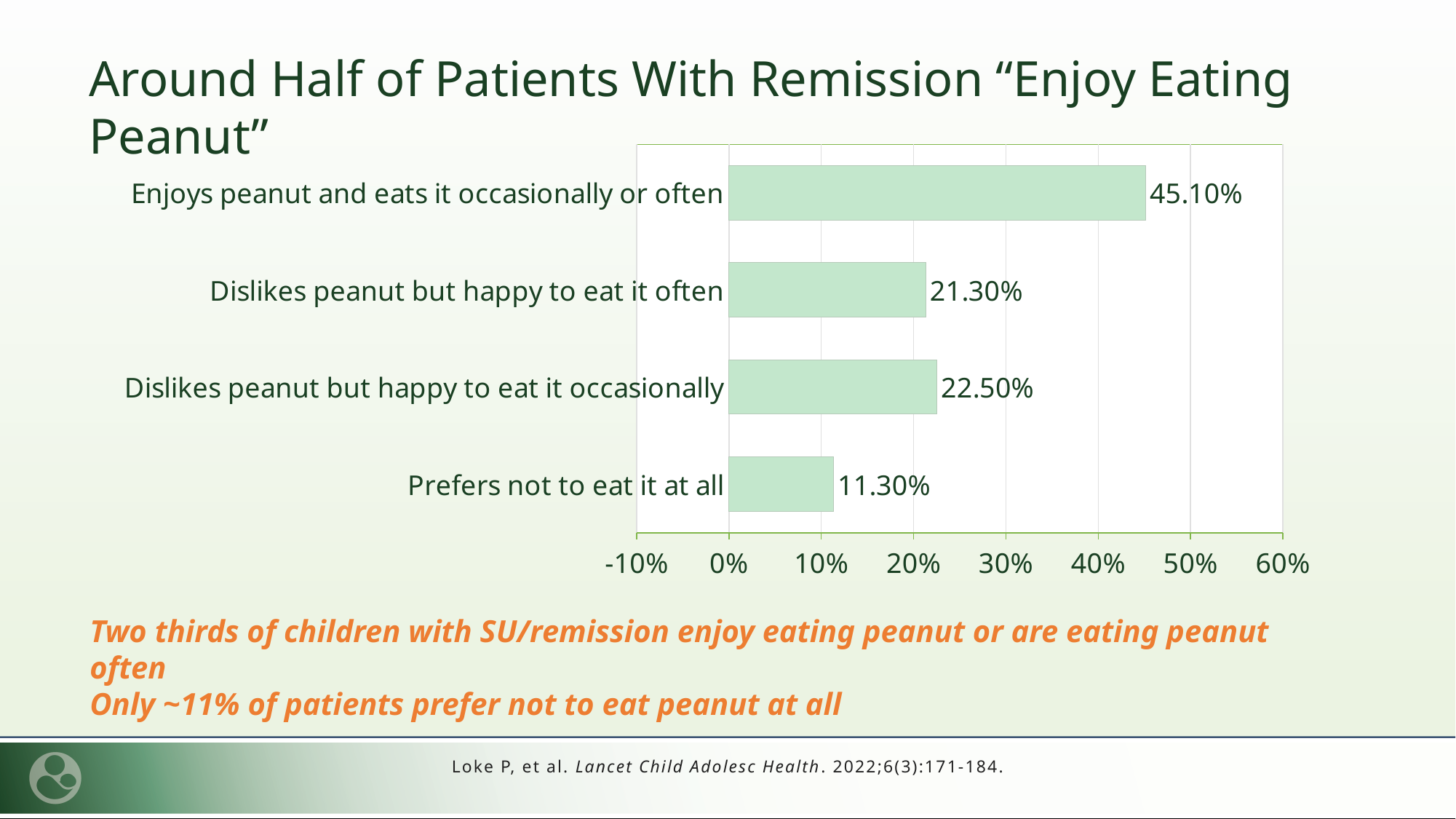
What is the difference between the values for "Dislikes peanut but happy to eat it occasionally" and "Dislikes peanut but happy to eat it often"? 1.20% What is the difference between the values for "Enjoys peanut and eats it occasionally or often" and "Prefers not to eat it at all"? 33.80% Which category has the lowest value? Prefers not to eat it at all What is the value for "Dislikes peanut but happy to eat it occasionally"? 22.50% What is the value for "Enjoys peanut and eats it occasionally or often"? 45.10% What kind of chart is shown on the slide? Bar chart How many categories are shown in the chart? 4 Which category has the highest value? Enjoys peanut and eats it occasionally or often Is the value for "Enjoys peanut and eats it occasionally or often" greater or less than 40%? greater What is the value for "Dislikes peanut but happy to eat it often"? 21.30% Which is larger: the value for "Dislikes peanut but happy to eat it often" or the value for "Prefers not to eat it at all"? Dislikes peanut but happy to eat it often What is the value for "Prefers not to eat it at all"? 11.30%